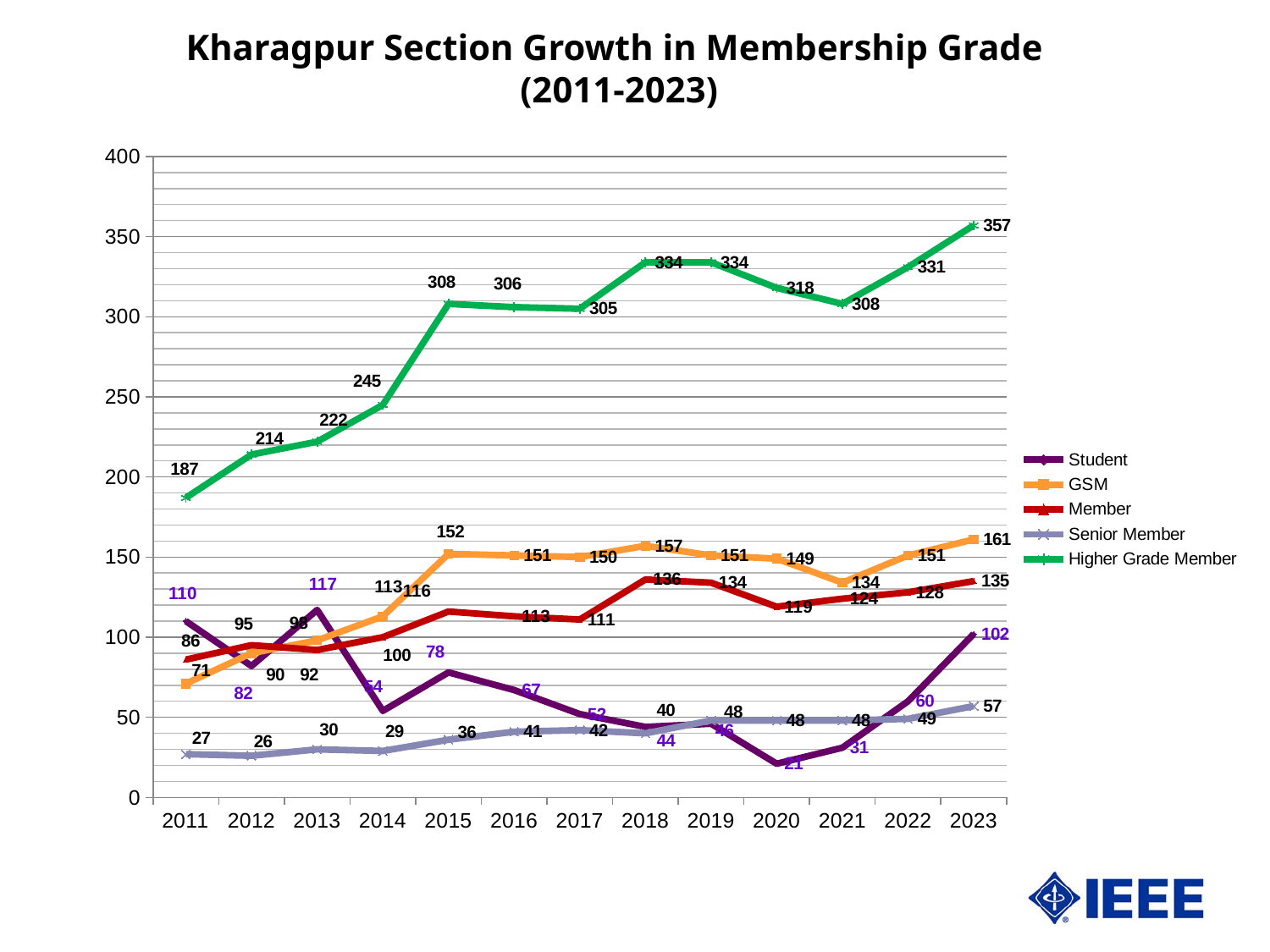
How many series does the legend list? 5 Which is larger in 2015, the GSM value or the Member value? GSM In which year is the Student value lowest? 2020 What is the Senior Member value for 2023? 57 What is the GSM value for 2023? 161 In which year is the Higher Grade Member value highest? 2023 Does the Senior Member series generally rise or fall from 2011 to 2023? rise How many years are plotted along the x axis? 13 By how much did the Higher Grade Member value increase from 2011 to 2023? 170 What is the Higher Grade Member value for 2023? 357 What type of chart is shown on the slide? line chart What is the Student value for 2020? 21